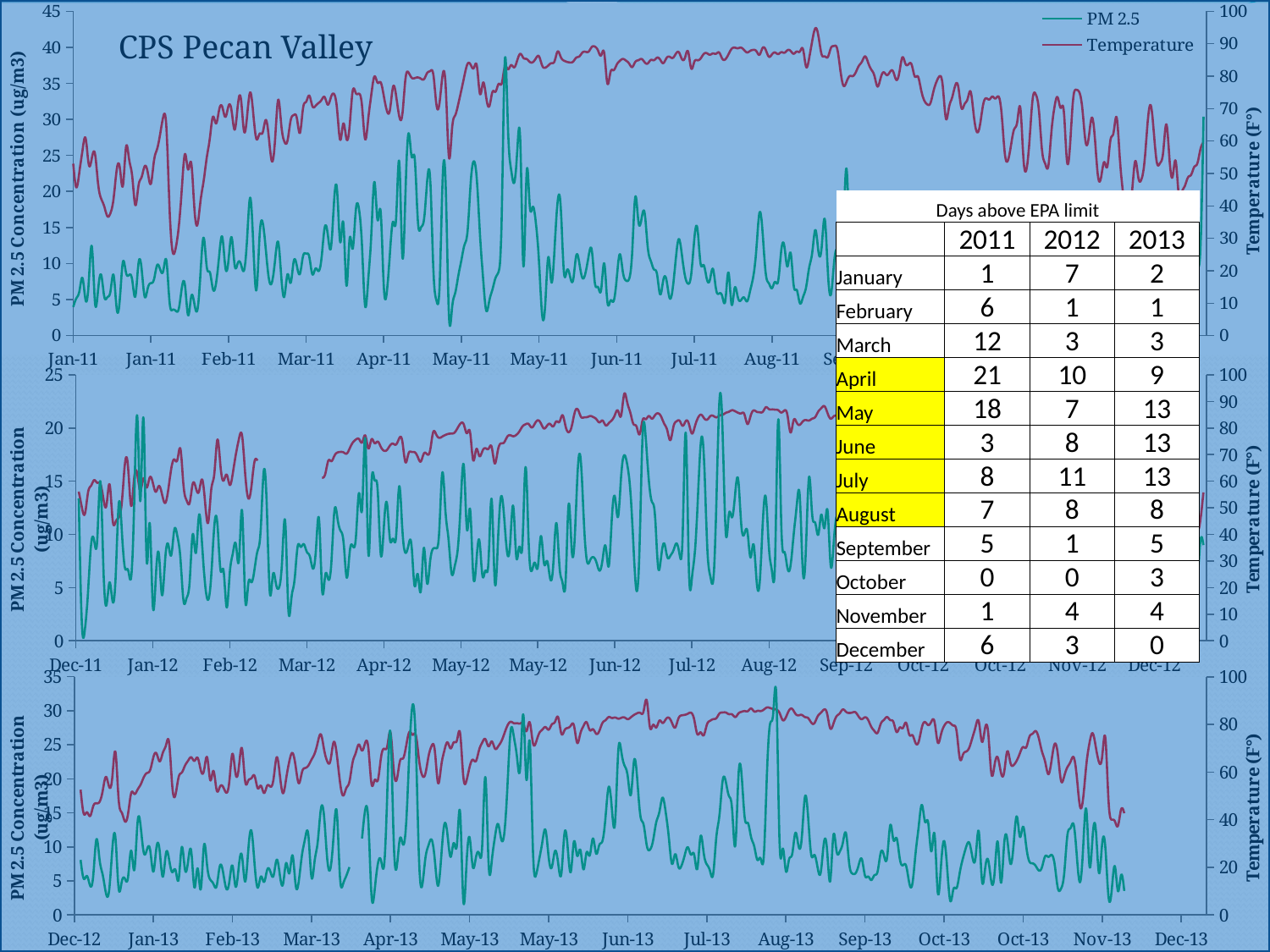
What kind of chart is the top chart on the slide? line chart In the top chart, is the Temperature value around Aug-11 greater or less than 80? greater In the bottom chart, is the Temperature value around Jul-13 greater or less than 60? greater How many line charts are shown on the slide? 3 What are the two series named in the legend of the top chart? PM 2.5 and Temperature In the top chart, is the Temperature value at the very start of Jan-11 greater or less than 60? less How many series does the legend of the top chart list? 2 In the top chart, does the Temperature line generally rise or fall from Jan-11 to Aug-11? rise In the bottom chart, does the Temperature line generally rise or fall from Sep-13 to Dec-13? fall What is the title shown on the top chart? CPS Pecan Valley